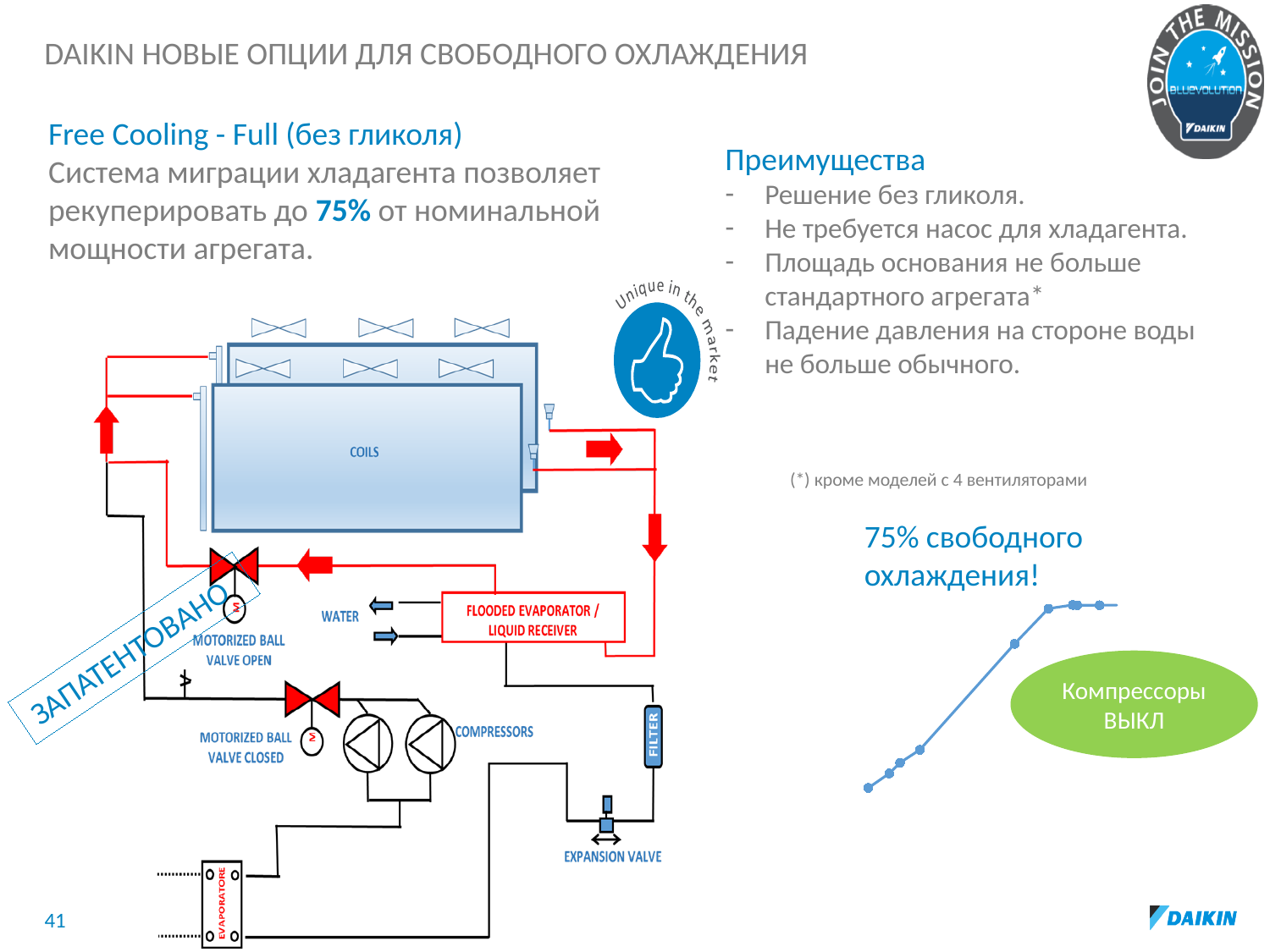
In the line chart at the bottom right, do the values rise or fall from left to right? rise What caption appears directly above the line chart at the bottom right? 75% свободного охлаждения! In the line chart at the bottom right, does the line keep rising at the right end or does it level off? levels off What text is written in the green oval next to the line chart? Компрессоры ВЫКЛ What kind of chart is shown at the bottom right of the slide, next to the green oval? line chart